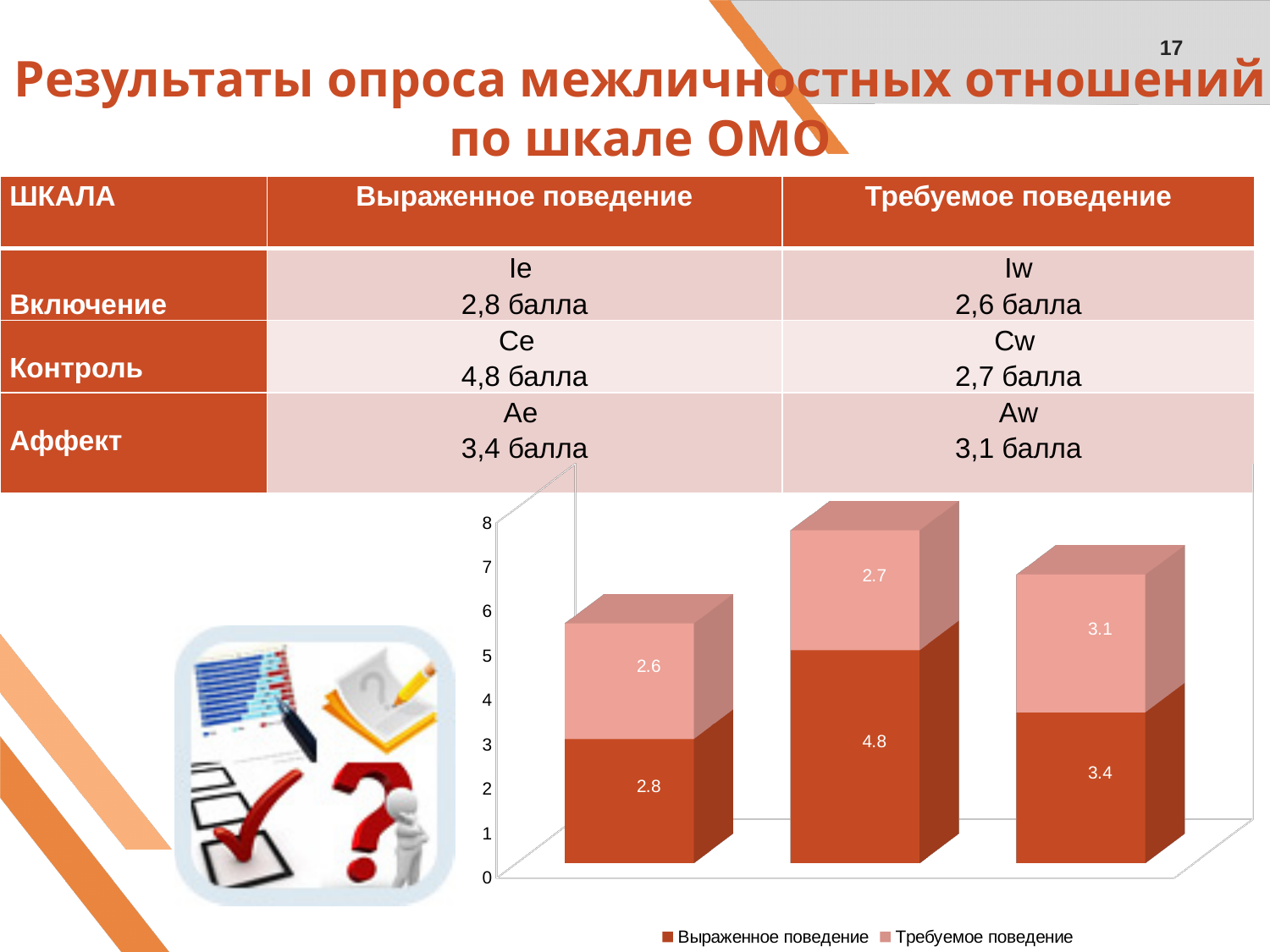
What are the two entries in the chart legend? Выраженное поведение and Требуемое поведение What is the Требуемое поведение value labelled on the middle bar? 2.7 What is the total of the two segments in the middle stacked bar? 7.5 What kind of chart is shown on the slide? stacked bar chart What is the Требуемое поведение value labelled on the third (rightmost) bar? 3.1 What is the difference between the Выраженное поведение and Требуемое поведение values in the middle bar? 2.1 In the rightmost bar, which is larger: Выраженное поведение or Требуемое поведение? Выраженное поведение Which bar has the lowest Требуемое поведение value? the first (leftmost) bar (2.6) How many series does the chart legend list? 2 What is the Выраженное поведение value labelled on the first (leftmost) bar? 2.8 Which bar has the highest Выраженное поведение value? the middle bar (4.8) How many stacked bars are plotted in the chart? 3